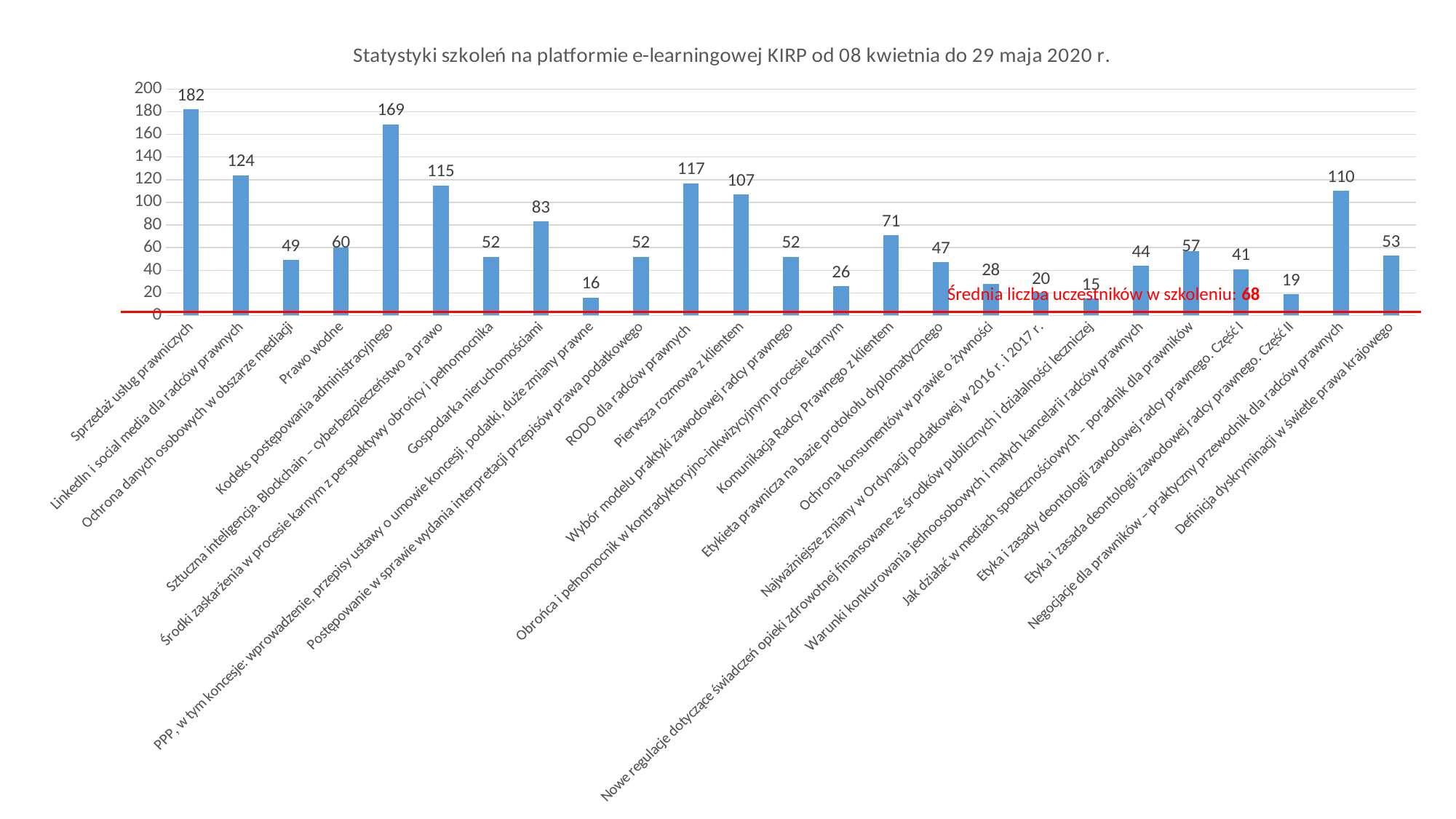
What is the difference between 'Sprzedaż usług prawniczych' and 'Kodeks postępowania administracyjnego'? 13 How many trainings (bars) are shown in the chart? 25 Which training has the highest number of participants? Sprzedaż usług prawniczych Which training has the lowest number of participants? Nowe regulacje dotyczące świadczeń opieki zdrowotnej finansowane ze środków publicznych i działalności leczniczej What is the difference between 'LinkedIn i social media dla radców prawnych' and 'Ochrona danych osobowych w obszarze mediacji'? 75 What is the value for 'Prawo wodne'? 60 What is the average number of participants per training indicated by the red line? 68 What type of chart is shown on the slide? bar chart What is the value for 'RODO dla radców prawnych'? 117 Which has more participants: 'Pierwsza rozmowa z klientem' or 'Negocjacje dla prawników – praktyczny przewodnik dla radców prawnych'? Negocjacje dla prawników – praktyczny przewodnik dla radców prawnych How many participants attended the training 'Sprzedaż usług prawniczych'? 182 What is the value for 'Gospodarka nieruchomościami'? 83